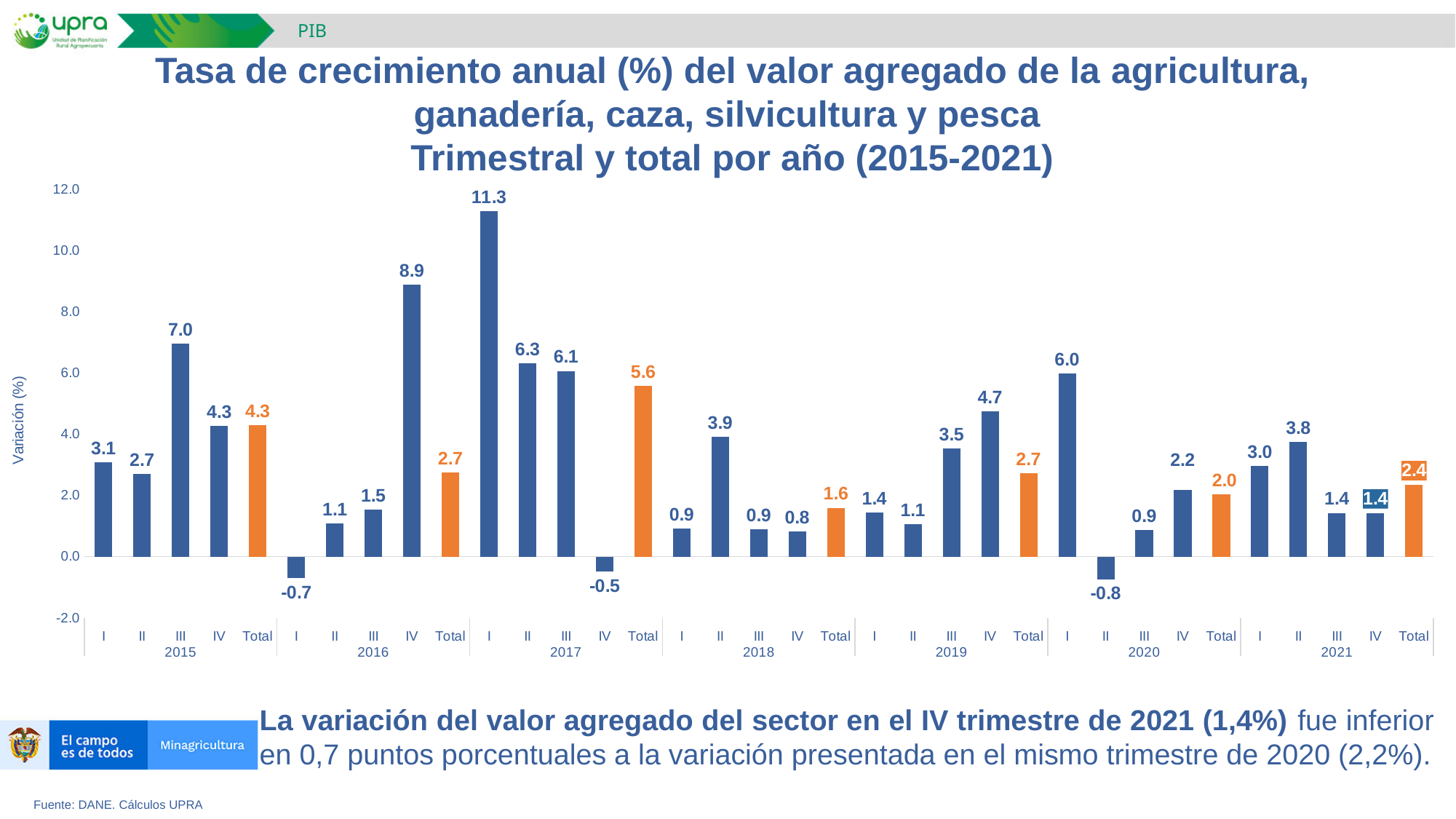
Which is larger: the Total for 2015 or the Total for 2018? Total 2015 What is the value for the second quarter (II) of 2020? -0.8 What kind of chart is shown on the slide? Bar chart Which bar has the lowest value on the chart? II 2020 What is the difference between the value for IV 2020 (2.2) and IV 2021 (1.4)? 0.8 What colour are the Total bars for each year? Orange How many bars are plotted on the chart in total? 35 What is the growth rate shown for the fourth quarter (IV) of 2016? 8.9 Which bar has the highest value on the chart? I 2017 What is the annual growth rate for the first quarter (I) of 2017? 11.3 What is the value of the Total bar for 2017? 5.6 Do the quarterly values for 2021 rise or fall from quarter II to quarter IV? Fall